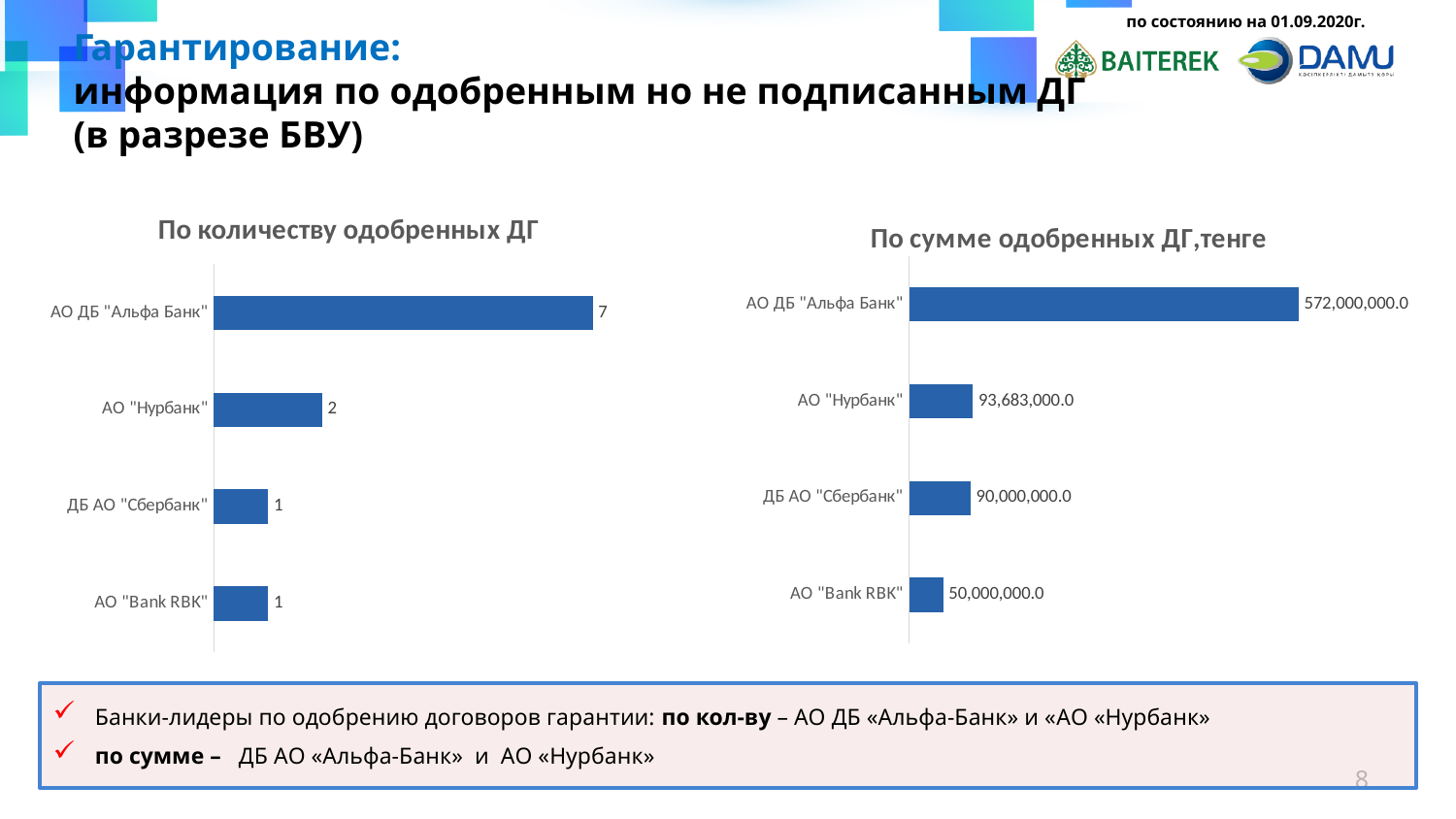
In the chart "По сумме одобренных ДГ,тенге", what is the value for АО "Bank RBK"? 50,000,000.0 In the chart "По количеству одобренных ДГ", what is the value for АО ДБ "Альфа Банк"? 7 What type of chart is "По сумме одобренных ДГ,тенге"? bar chart In the chart "По количеству одобренных ДГ", what is the difference between АО ДБ "Альфа Банк" and АО "Нурбанк"? 5 How many banks are shown in the chart "По количеству одобренных ДГ"? 4 In the chart "По сумме одобренных ДГ,тенге", what is the difference between АО "Нурбанк" and ДБ АО "Сбербанк"? 3,683,000.0 What is the title of the left chart on the slide? По количеству одобренных ДГ In the chart "По количеству одобренных ДГ", what is the value for АО "Нурбанк"? 2 In the chart "По сумме одобренных ДГ,тенге", which bank has the highest value? АО ДБ "Альфа Банк" In the chart "По сумме одобренных ДГ,тенге", which is larger: АО "Нурбанк" or АО "Bank RBK"? АО "Нурбанк" In the chart "По сумме одобренных ДГ,тенге", which bank has the lowest value? АО "Bank RBK" In the chart "По сумме одобренных ДГ,тенге", what is the value for ДБ АО "Сбербанк"? 90,000,000.0